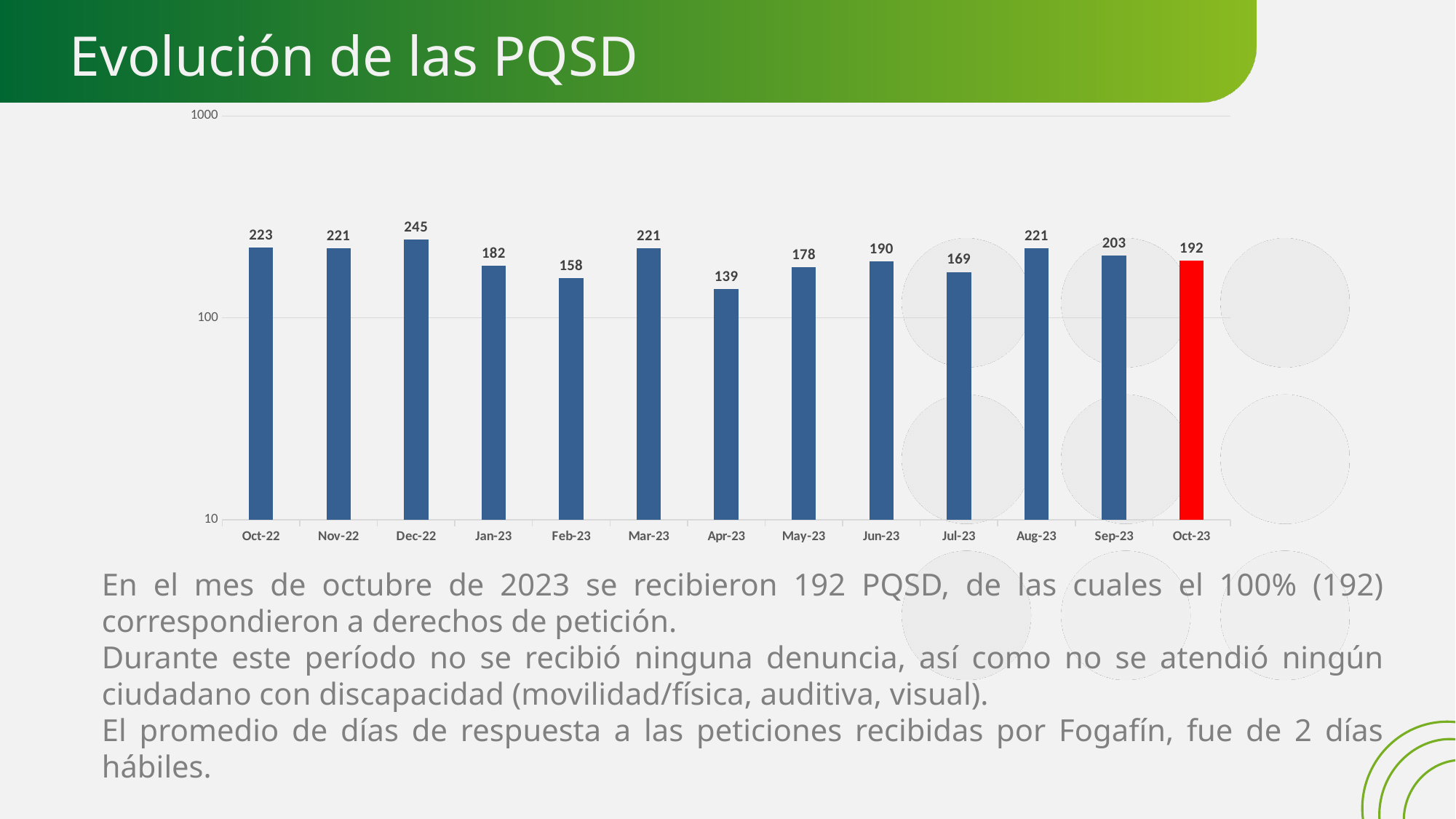
How many months are shown on the x axis? 13 Which month has the lowest value? Apr-23 What is the value for Apr-23? 139 What kind of chart is shown on the slide? bar chart What is the difference between the values for Sep-23 and Oct-23? 11 What is the value for Oct-23? 192 Which month has the highest value? Dec-22 Is the value for Jul-23 greater or less than 100? greater Which is larger, the value for Jan-23 or the value for Feb-23? Jan-23 Which bar is coloured red instead of blue? Oct-23 What is the value for Dec-22? 245 What is the difference between the values for Dec-22 and Apr-23? 106